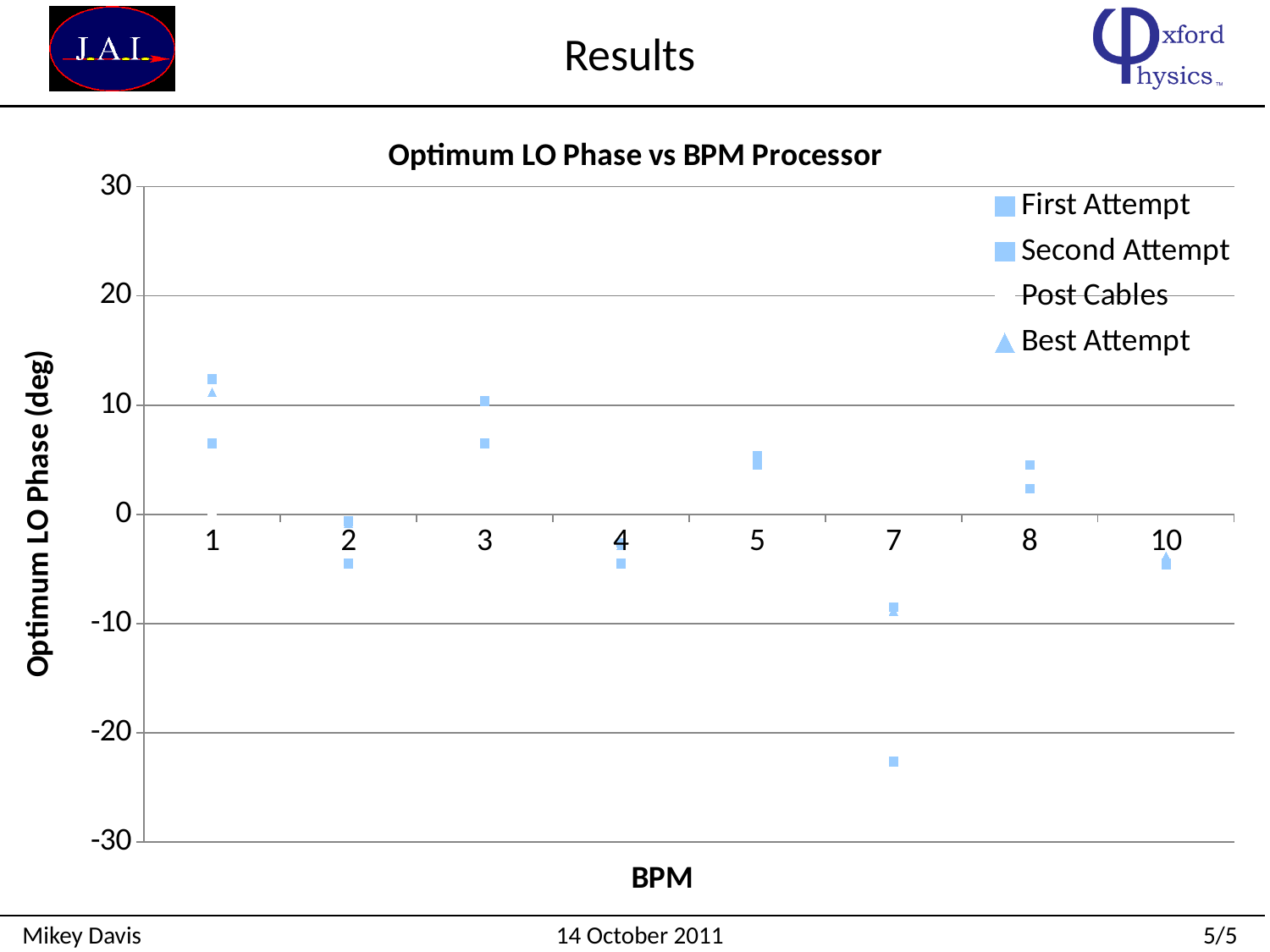
Is the lowest plotted point for BPM 7 greater or less than -20? less What is the title of the chart? Optimum LO Phase vs BPM Processor Are the plotted points for BPM 4 greater or less than 0? less Are the plotted points for BPM 8 greater or less than 0? greater What is the label of the y axis? Optimum LO Phase (deg) How many series does the legend list? 4 How many BPM categories are shown on the x axis? 8 What type of chart is shown on the slide? scatter chart Which BPM has the highest plotted point on the chart? 1 Which BPM has the lowest plotted point on the chart? 7